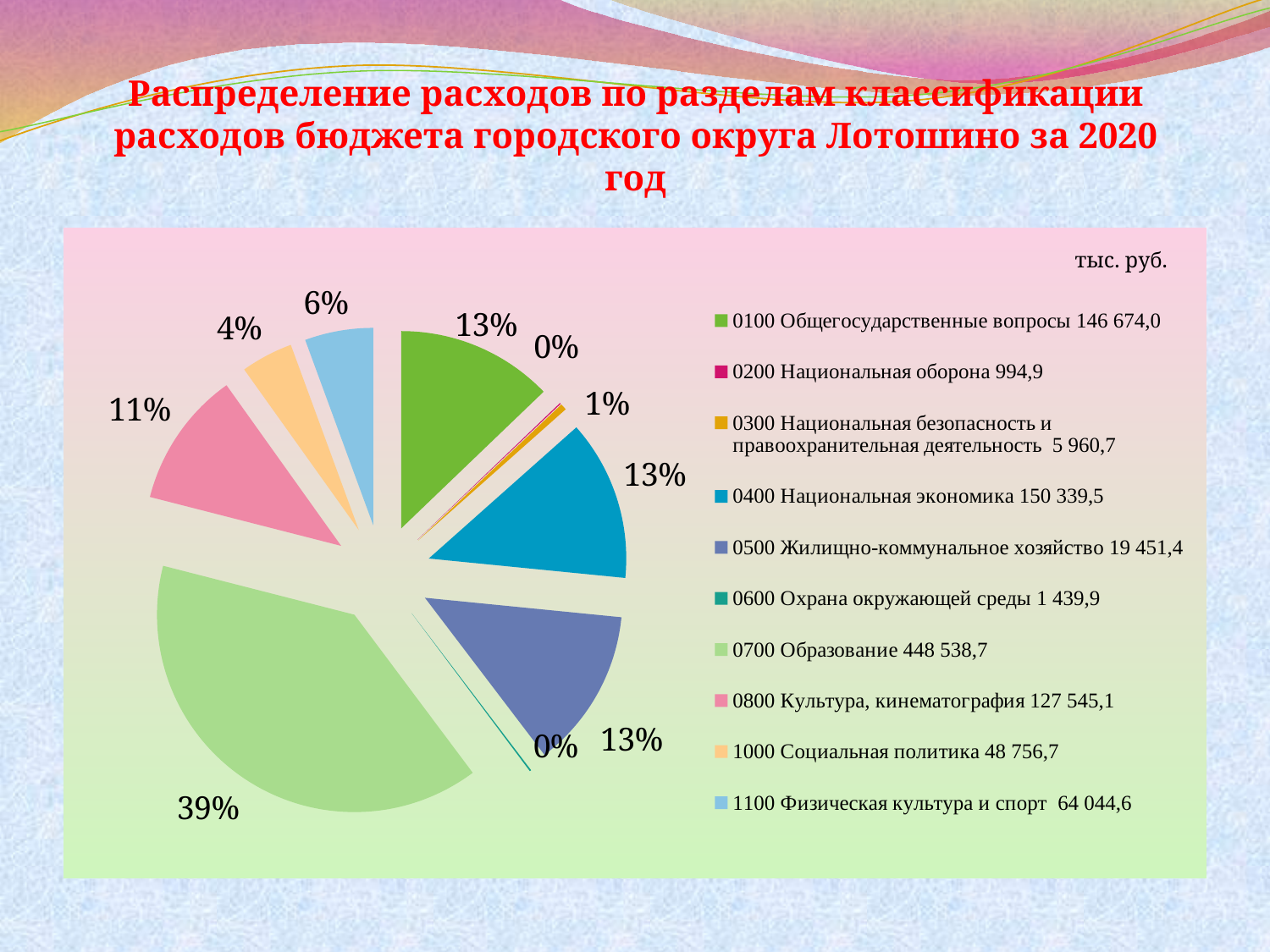
What value is shown in the legend for 0400 Национальная экономика? 150 339,5 What share of the pie does 1100 Физическая культура и спорт have? 6% Which category has the largest share of the pie? 0700 Образование How many categories (slices) does the pie chart have? 10 In what units are the legend values given, according to the label in the top right of the chart? тыс. руб. What kind of chart is shown on the slide? Pie chart What share of the pie does 0700 Образование have? 39% What value is shown in the legend for 0200 Национальная оборона? 994,9 What value is shown in the legend for 1000 Социальная политика? 48 756,7 Which has the larger share of the pie: 0700 Образование or 0800 Культура, кинематография? 0700 Образование What is the difference in percentage points between the share of 0700 Образование (39%) and the share of 0100 Общегосударственные вопросы (13%)? 26% What share of the pie does 0800 Культура, кинематография have? 11%